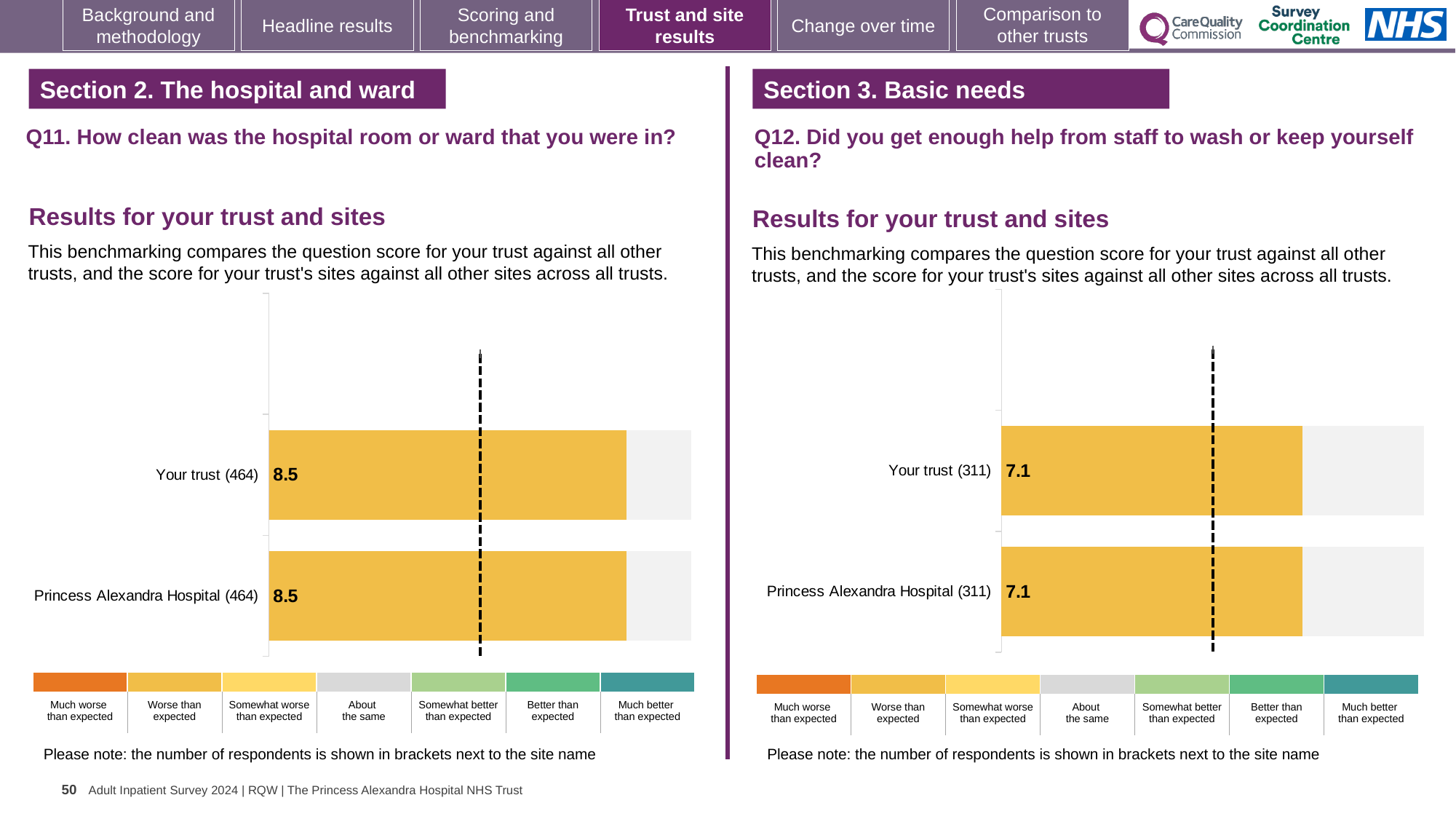
On the Q12 chart (right), how many respondents are shown in brackets next to Princess Alexandra Hospital? 311 How many bars are plotted on the Q11 chart (left)? 2 On the Q12 chart (right), what is the score for Princess Alexandra Hospital? 7.1 Is the score for Your trust on the Q11 chart (left) larger or smaller than the score for Your trust on the Q12 chart (right)? Larger On the Q11 chart (left), how many respondents are shown in brackets next to Your trust? 464 On the Q11 chart (left), what is the score for Princess Alexandra Hospital? 8.5 On the Q12 chart (right), what is the difference between the score for Your trust and the score for Princess Alexandra Hospital? 0 How many bars are plotted on the Q12 chart (right)? 2 On the Q11 chart (left), what is the score for Your trust? 8.5 What kind of chart is the Q11 chart (left)? Bar chart On the Q12 chart (right), what is the score for Your trust? 7.1 On the Q11 chart (left), what is the difference between the score for Your trust and the score for Princess Alexandra Hospital? 0